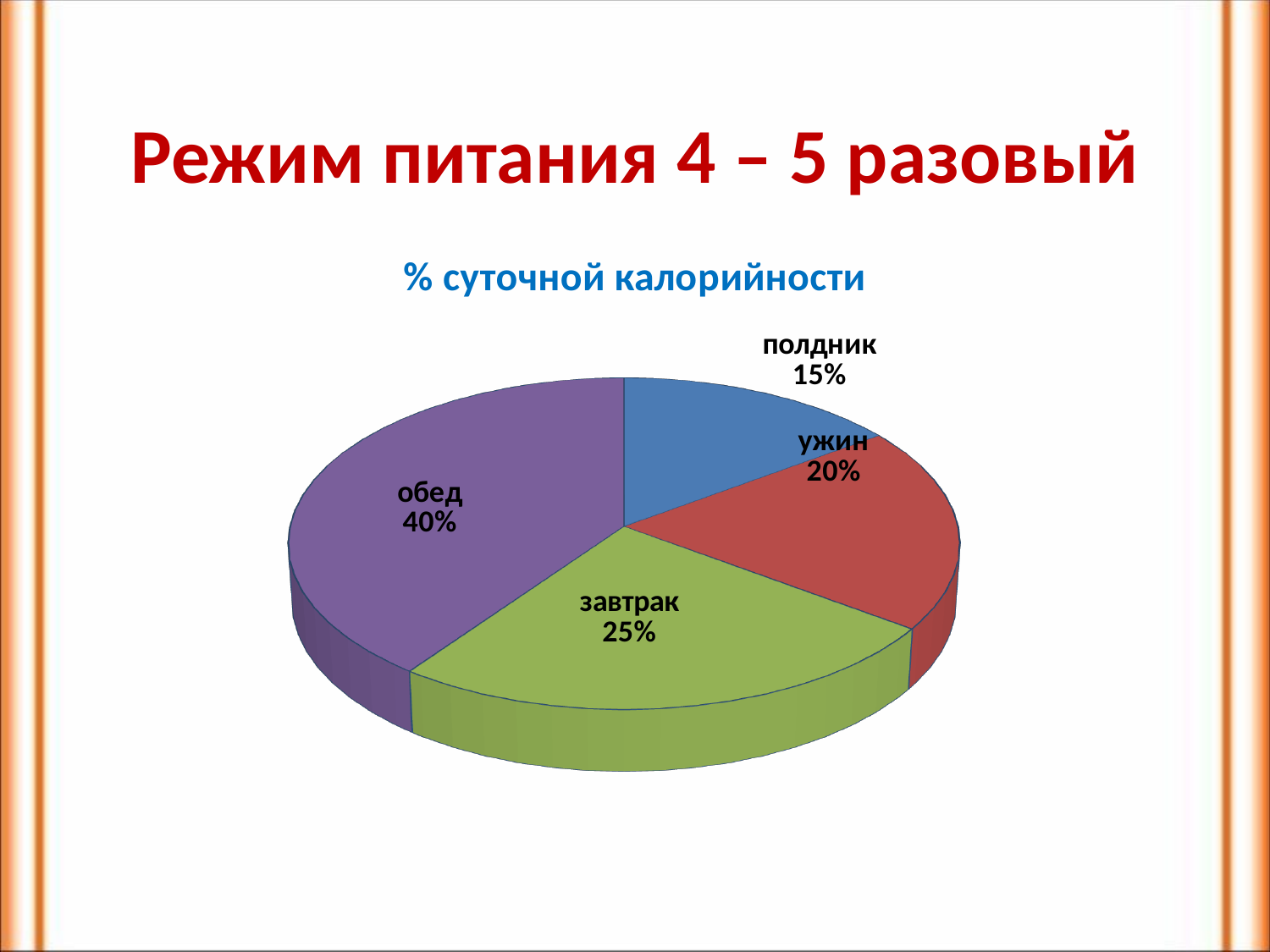
What is the difference between the shares for обед and завтрак? 15% What is the value shown for ужин? 20% What colour is the slice for обед? purple Which meal has the smallest share of the pie? полдник What is the chart's title? % суточной калорийности Which is larger, the share for ужин or the share for полдник? ужин What share of daily calories does обед account for? 40% What kind of chart is shown on the slide? pie chart How many slices does the pie chart have? 4 What is the value shown for завтрак? 25% Which meal has the largest share of the pie? обед What is the value shown for полдник? 15%